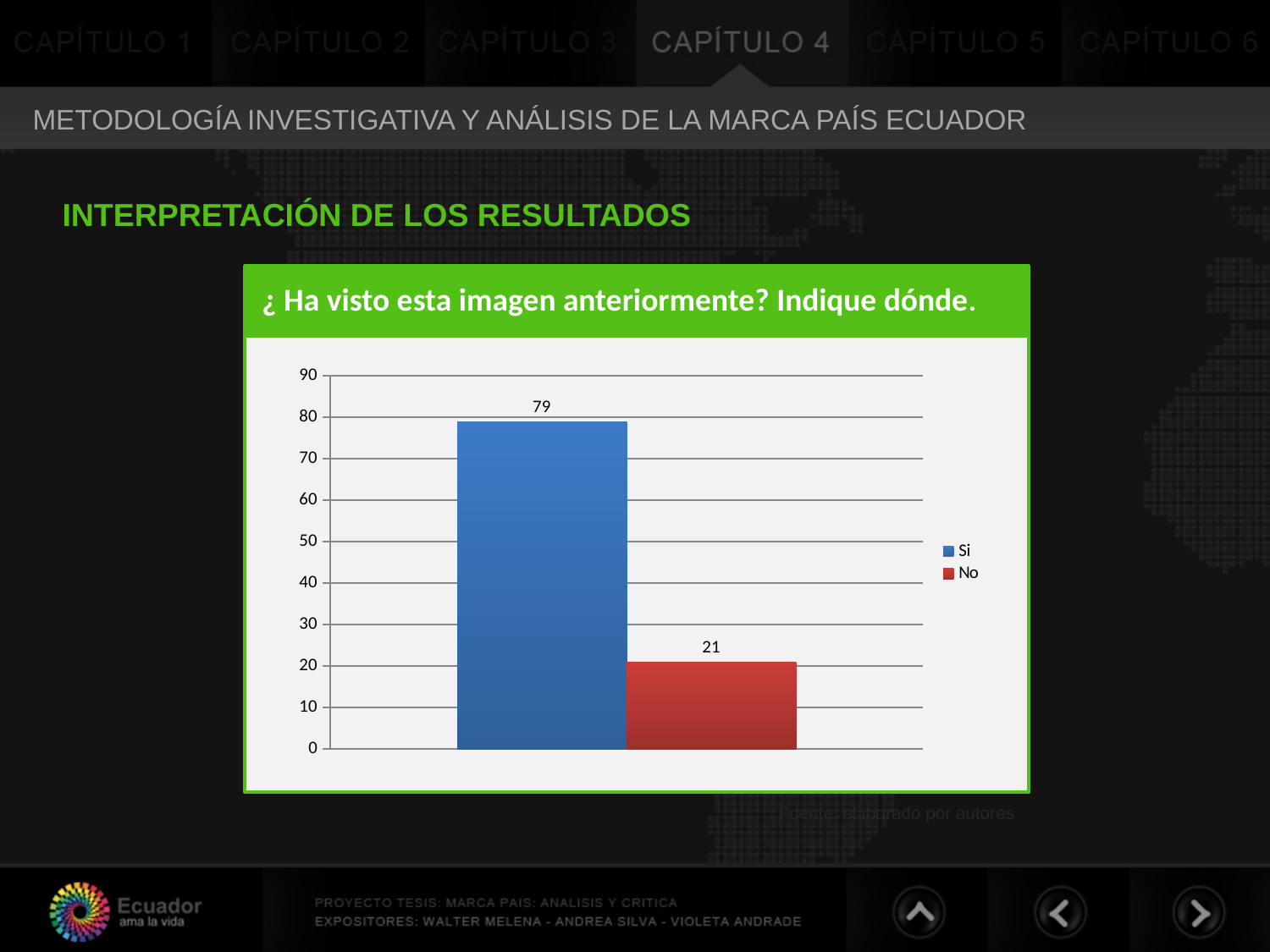
How many series does the legend list? 2 What kind of chart is shown on the slide? Bar chart Is the value for "No" greater or less than 30? less Which series has the lowest value? No Is the value for "Si" greater or less than 70? greater Which is larger, the value for "Si" or the value for "No"? Si Which series has the highest value? Si What is the difference between the values for "Si" and "No"? 58 What is the title of the chart? ¿ Ha visto esta imagen anteriormente? Indique dónde. How many bars are plotted in the chart? 2 What is the value for "No"? 21 What is the value for "Si"? 79